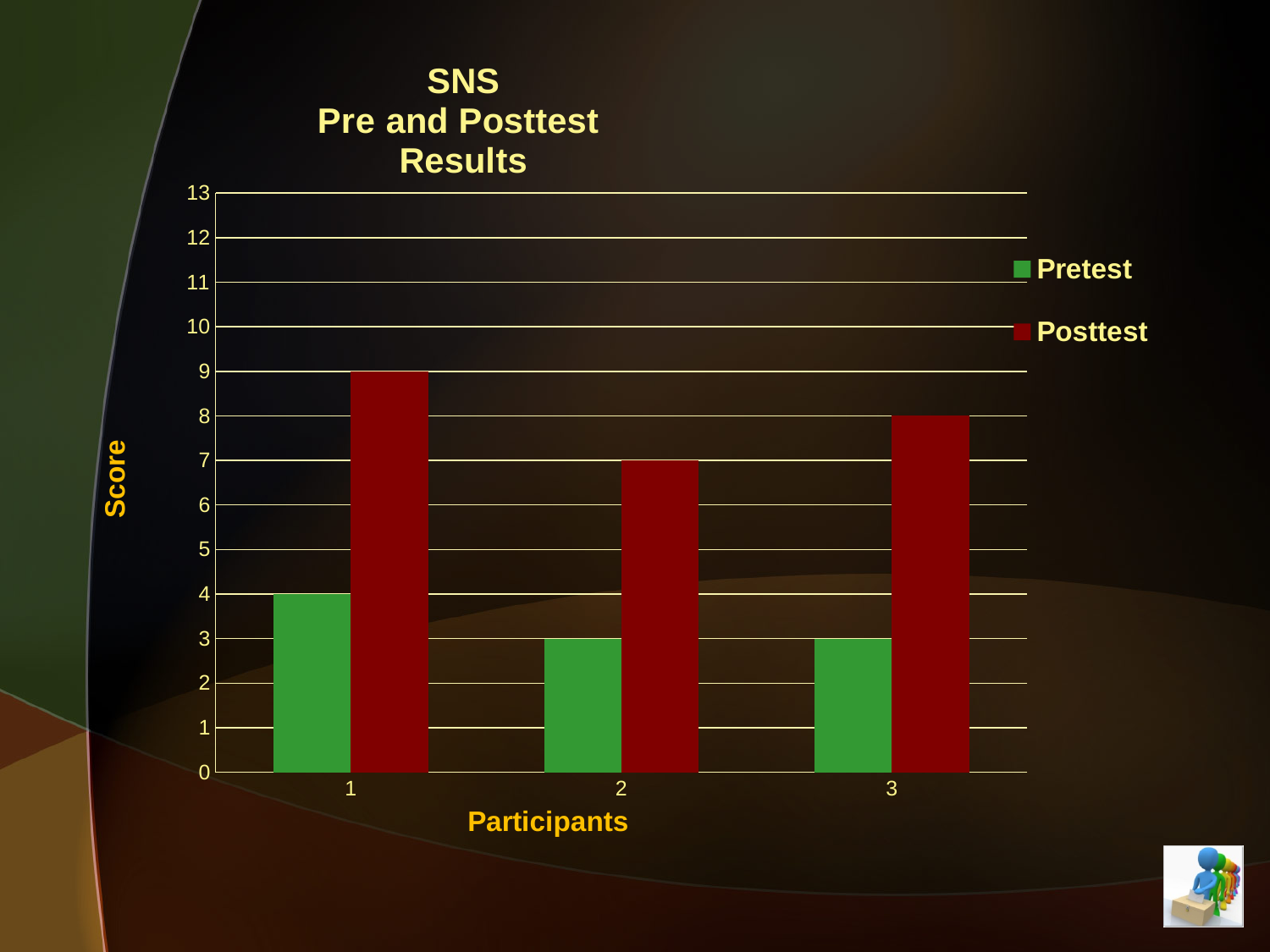
How many participants are shown on the x axis? 3 Which participant has the lowest Posttest score? 2 What is the Posttest score for participant 3? 8 Is the Posttest score for participant 1 greater or less than 5? greater What is the difference between the Posttest and Pretest scores for participant 1? 5 What is the Posttest score for participant 2? 7 What kind of chart is shown on the slide? bar chart What is the label of the y axis? Score How many series does the legend list? 2 What is the Pretest score for participant 1? 4 Which participant has the highest Posttest score? 1 Which is larger for participant 3, the Pretest score or the Posttest score? Posttest